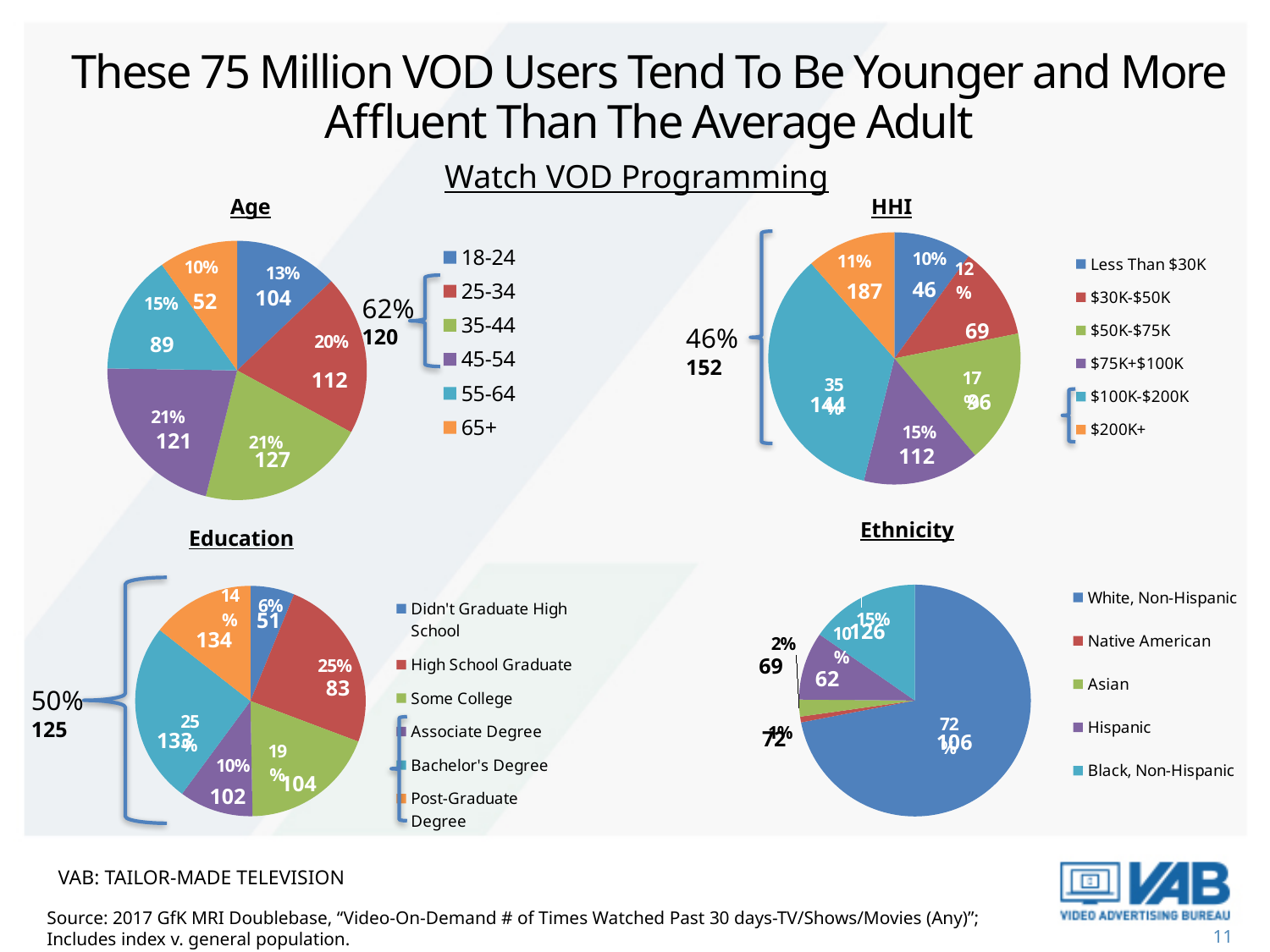
What kind of chart is the Age chart? pie chart In the Ethnicity chart, what is the difference in percentage points between the Black, Non-Hispanic share and the Hispanic share? 5 In the Education chart, which is larger, the share for Associate Degree or the share for Post-Graduate Degree? Post-Graduate Degree How many categories does the legend of the Age chart list? 6 In the Age chart, what index value is shown for the 65+ slice? 52 In the HHI chart, what index value is shown for the $200K+ slice? 187 In the Ethnicity chart, what percentage share is shown for the White, Non-Hispanic slice? 72% In the HHI chart, which income group has the largest share? $100K-$200K In the Age chart, what percentage share is shown for the 35-44 slice? 21% In the Education chart, what percentage share is shown for the High School Graduate slice? 25% In the HHI chart, what percentage share is shown for the $200K+ slice? 11% In the Age chart, which age group has the smallest share? 65+